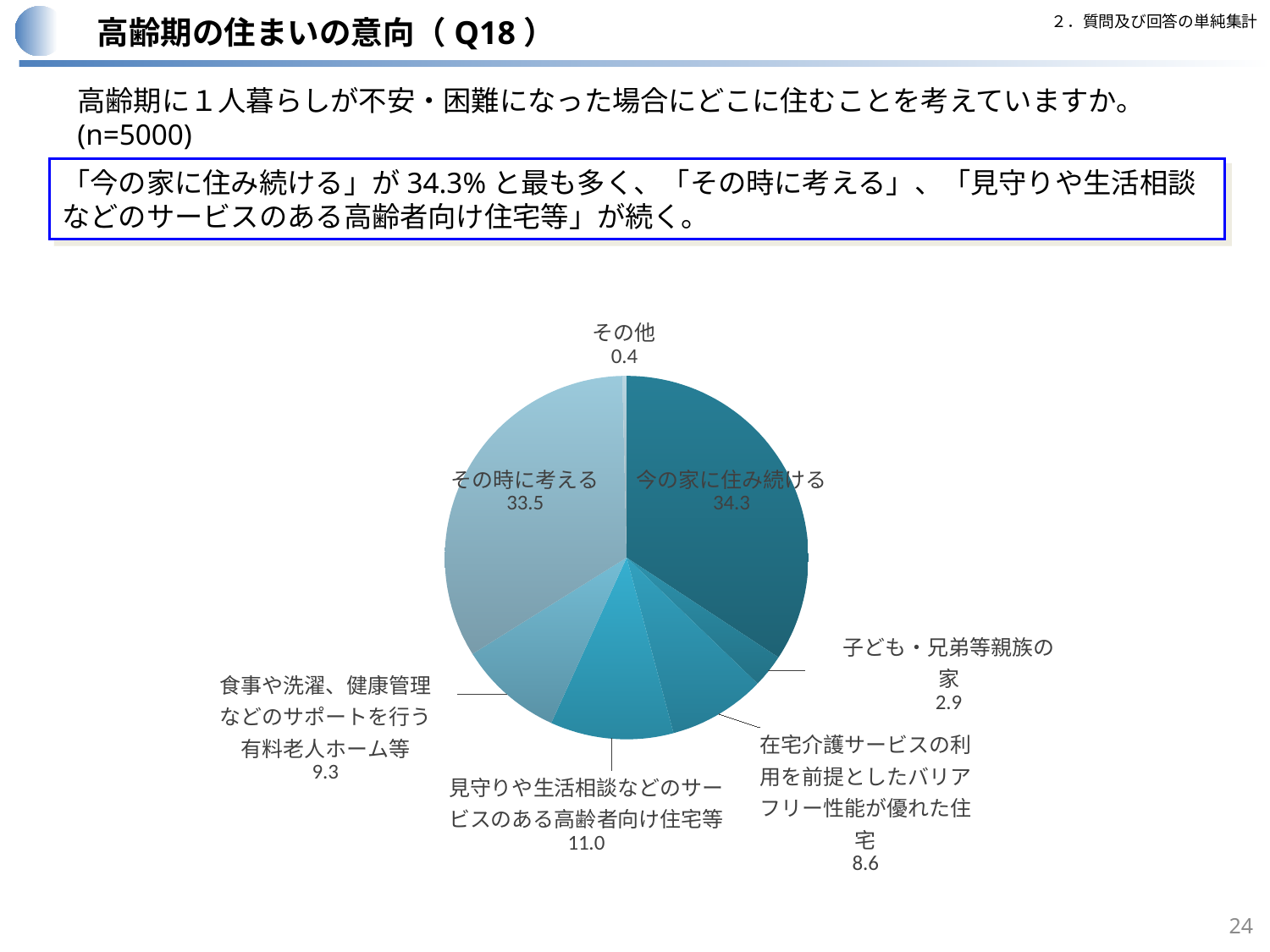
What is the difference between the values for 今の家に住み続ける and その時に考える? 0.8 What is the sample size (n) stated for the survey question on the slide? 5000 What is the value for 子ども・兄弟等親族の家? 2.9 What kind of chart is shown on the slide? pie chart What is the value for 見守りや生活相談などのサービスのある高齢者向け住宅等? 11.0 Which is larger, the value for 食事や洗濯、健康管理などのサポートを行う有料老人ホーム等 or the value for 在宅介護サービスの利用を前提としたバリアフリー性能が優れた住宅? 食事や洗濯、健康管理などのサポートを行う有料老人ホーム等 What is the value for その時に考える? 33.5 What is the difference between the values for 見守りや生活相談などのサービスのある高齢者向け住宅等 and 食事や洗濯、健康管理などのサポートを行う有料老人ホーム等? 1.7 How many slices does the pie chart have? 7 Which category has the smallest slice of the pie? その他 Which category has the largest slice of the pie? 今の家に住み続ける What is the value for 今の家に住み続ける? 34.3